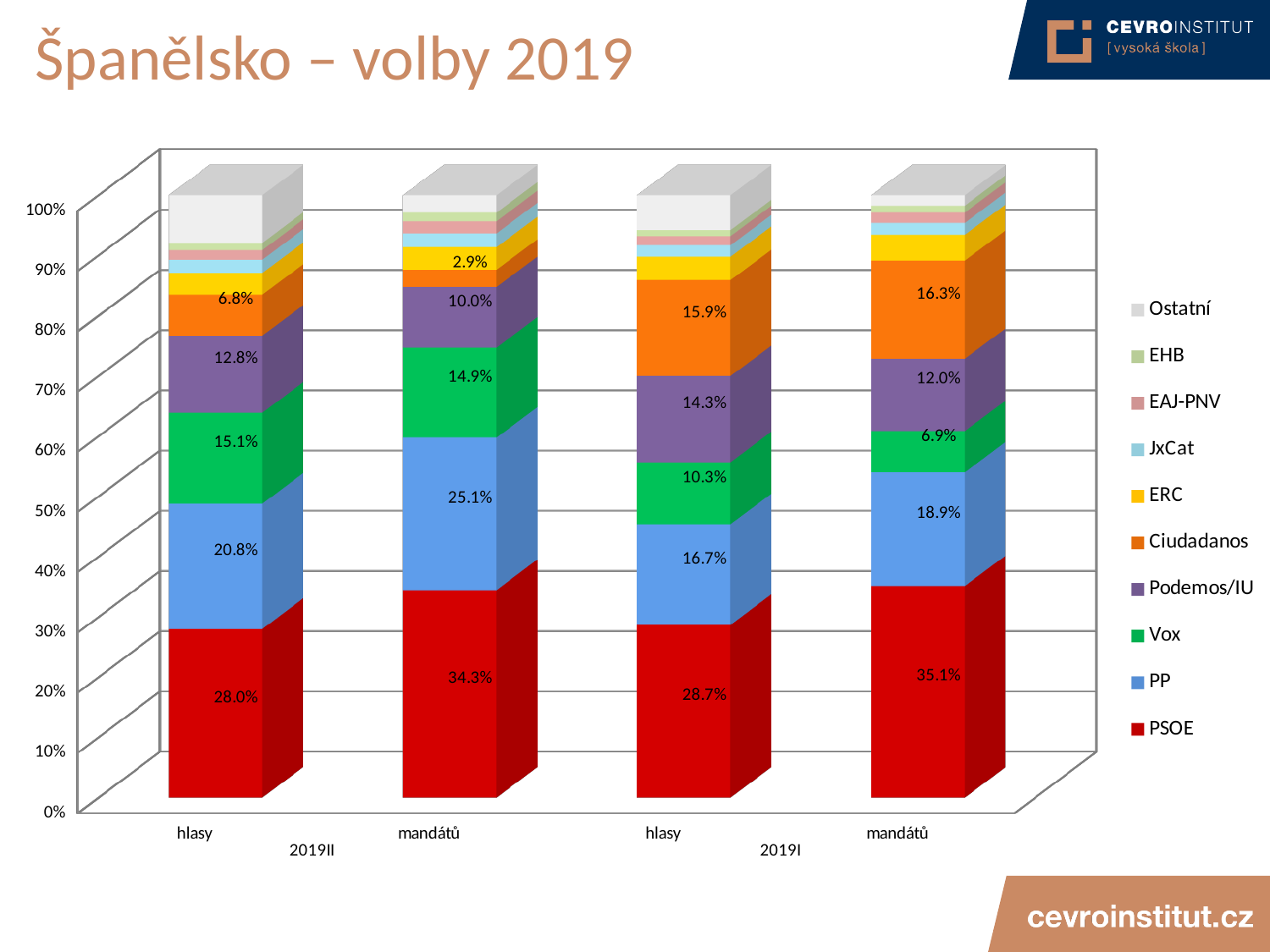
What is the difference between the Podemos/IU share in 'hlasy' 2019I and in 'mandátů' 2019I? 2.3% What is the Vox share in the 'mandátů' bar for 2019II? 14.9% How many bars are plotted in the chart? 4 What is the PSOE share in the 'mandátů' bar for 2019I? 35.1% What is the PP share in the 'hlasy' bar for 2019II? 20.8% What is the Ciudadanos share in the 'hlasy' bar for 2019I? 15.9% Which party has the largest share in the 'hlasy' bar for 2019II? PSOE What kind of chart is shown on the slide? Stacked bar chart What is the difference between the PSOE share in 'mandátů' 2019II and the PSOE share in 'hlasy' 2019II? 6.3% Which is larger: the Vox share in 'hlasy' 2019I or the Vox share in 'mandátů' 2019I? hlasy 2019I How many series does the legend list? 10